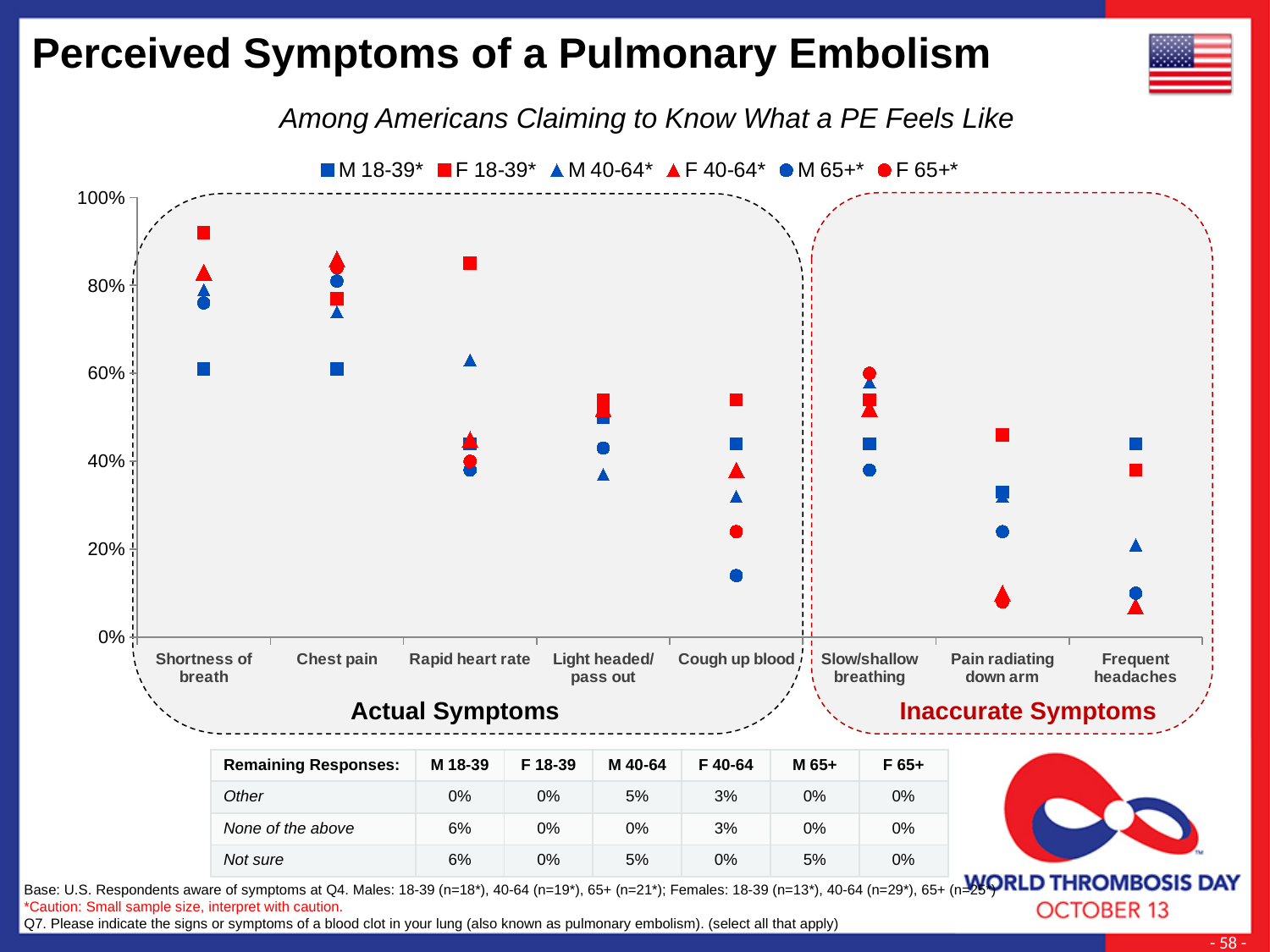
What kind of chart is used to show the perceived symptoms of a pulmonary embolism? Scatter (dot) plot How many symptoms are grouped under the 'Inaccurate Symptoms' label? 3 For Rapid heart rate, which is larger: the value for F 18-39 or the value for M 65+? F 18-39 For Frequent headaches, which is larger: the value for M 18-39 or the value for M 40-64? M 18-39 Is the value for F 18-39 on Shortness of breath greater or less than 80%? greater Which series has the lowest value for Cough up blood? M 65+ How many series does the legend list? 6 Is the value for F 18-39 on Pain radiating down arm greater or less than 40%? greater Is the value for M 18-39 on Chest pain greater or less than 80%? less How many symptom categories are shown along the x axis? 8